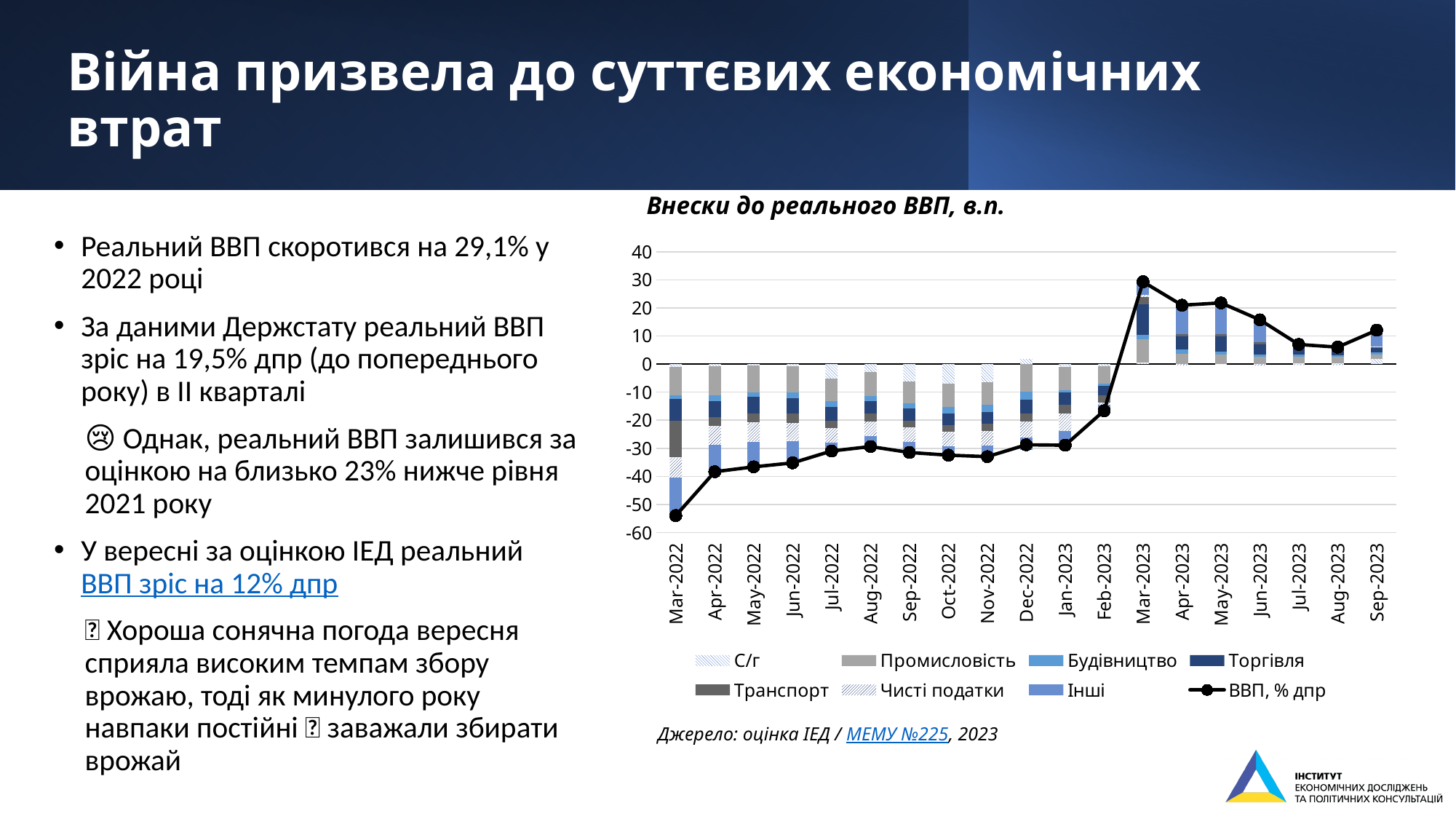
Which month has a higher value of 'ВВП, % дпр': Mar-2023 or Apr-2023? Mar-2023 Does the line 'ВВП, % дпр' rise or fall from Mar-2022 to Mar-2023? rise Is the value of 'ВВП, % дпр' for Mar-2022 greater or less than -50? less What is the title of the chart? Внески до реального ВВП, в.п. What kind of chart is shown on the slide? Stacked bar chart with a line Is the value of 'ВВП, % дпр' for Mar-2023 greater or less than 20? greater How many series does the chart legend list? 8 Is the value of 'ВВП, % дпр' for Jul-2023 greater or less than 10? less In which month does the line 'ВВП, % дпр' reach its highest value? Mar-2023 In which month does the line 'ВВП, % дпр' reach its lowest value? Mar-2022 How many months are shown on the x axis of the chart? 19